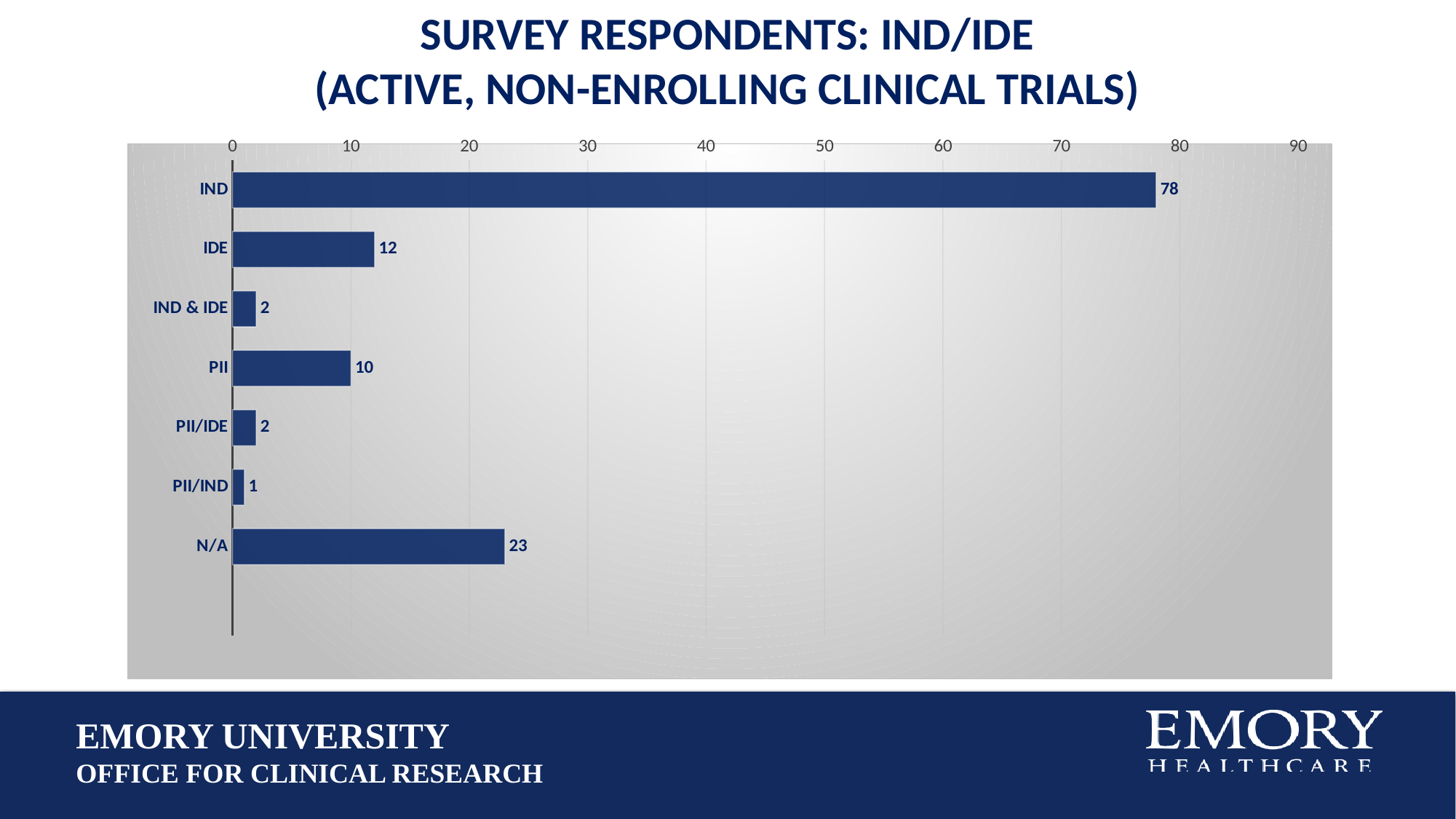
How many categories are shown in the chart? 7 What is the title of the chart? Survey Respondents: IND/IDE (Active, Non-Enrolling Clinical Trials) What is the value for PII? 10 What is the difference between the values for IND and N/A? 55 What is the value for N/A? 23 Is the value for IND greater or less than 70? greater What is the value for IDE? 12 Which category has the lowest value? PII/IND Which category has the highest value? IND Which is larger, the value for IDE or the value for PII? IDE What kind of chart is shown on the slide? bar chart What is the value for IND? 78